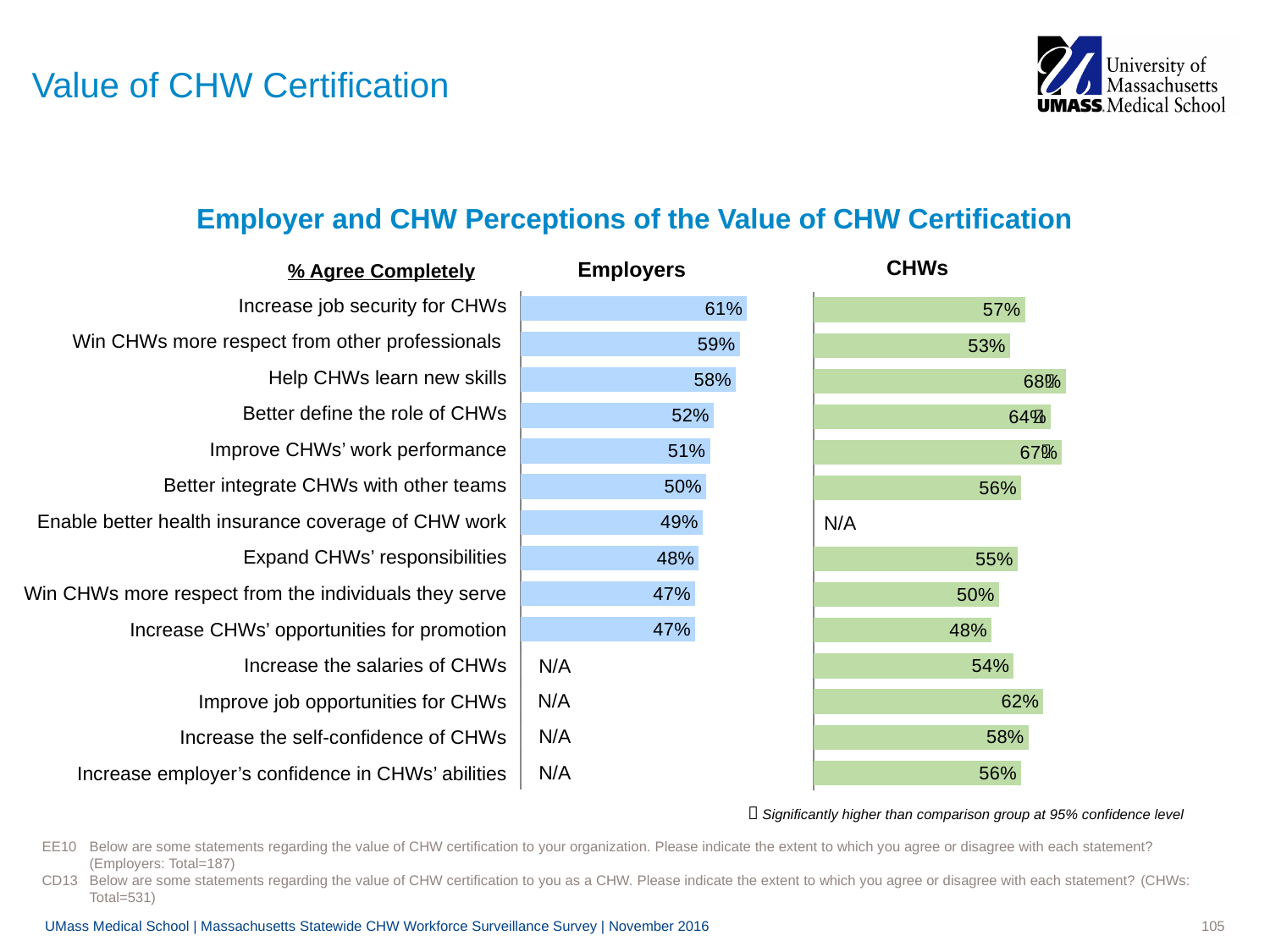
In the CHWs chart, what percentage agree completely that certification would increase the salaries of CHWs? 54% In the Employers chart, do the percentages rise or fall going down the list of statements? Fall In the CHWs chart, which statement is marked N/A? Enable better health insurance coverage of CHW work In the Employers chart, what percentage agree completely that certification would increase job security for CHWs? 61% In the Employers chart, how many statements have a percentage value rather than N/A? 10 What type of chart is used to show the Employers and CHWs percentages? Bar chart What is the difference between the Employers and CHWs percentages for 'Win CHWs more respect from other professionals'? 6 percentage points In the CHWs chart, what is the lowest percentage shown? 48% In the Employers chart, which statement has the highest percentage agreeing completely? Increase job security for CHWs In the CHWs chart, what percentage agree completely that certification would improve job opportunities for CHWs? 62% What is the title of the chart on the slide? Employer and CHW Perceptions of the Value of CHW Certification For 'Better integrate CHWs with other teams', which group has the higher percentage, Employers or CHWs? CHWs